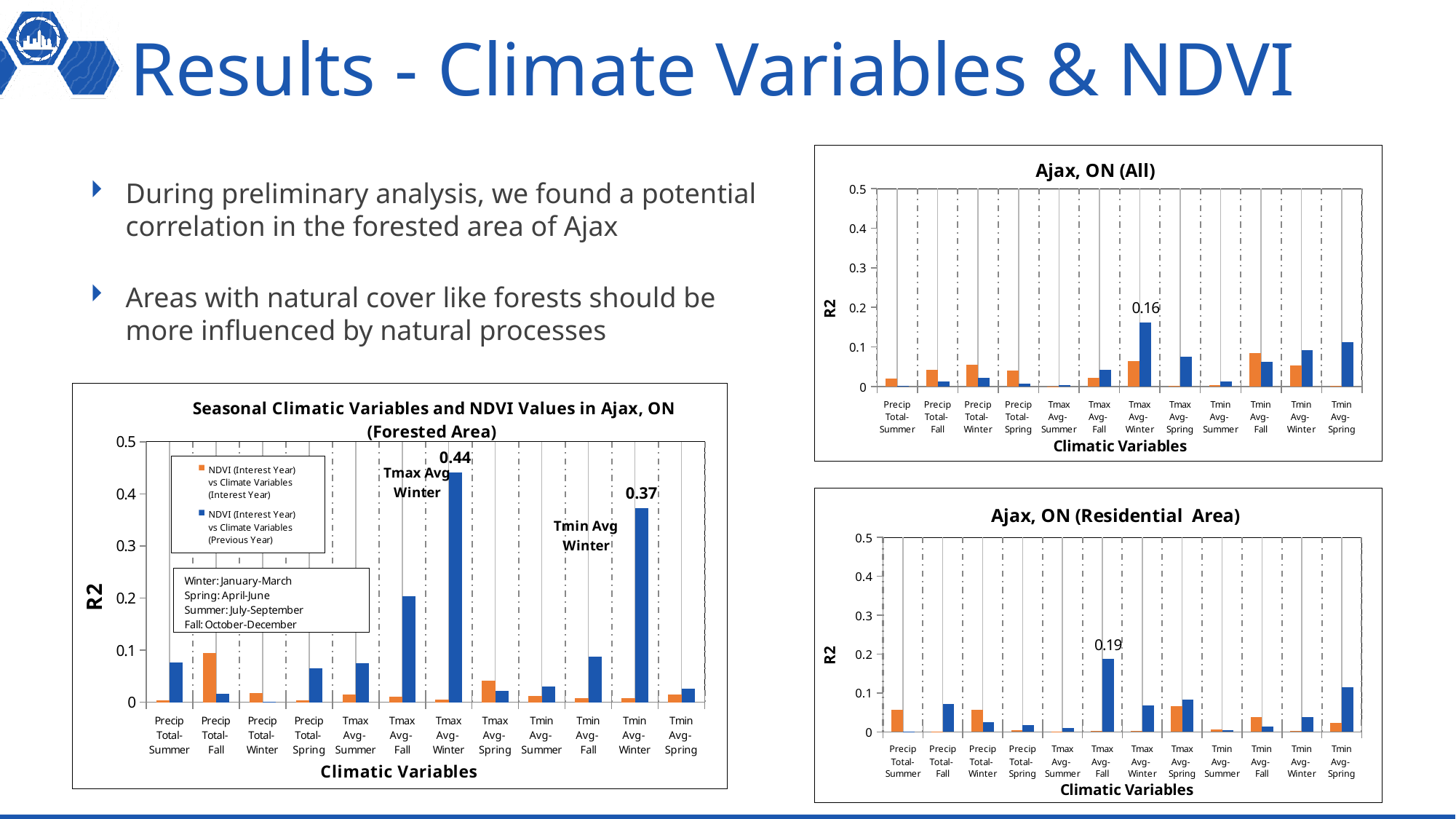
How many series does the legend of the Forested Area chart list? 2 In the 'Ajax, ON (Residential Area)' chart, which climatic variable has the highest R2 value? Tmax Avg-Fall In the 'Seasonal Climatic Variables and NDVI Values in Ajax, ON (Forested Area)' chart, what is the R2 value for Tmin Avg-Winter in the NDVI (Interest Year) vs Climate Variables (Previous Year) series? 0.37 In the Forested Area chart, is the R2 value for Tmin Avg-Winter in the Previous Year series greater or less than 0.3? greater How many climatic variable categories are shown on the x axis of the Forested Area chart? 12 In the Forested Area chart, which climatic variable has the highest R2 value? Tmax Avg-Winter What kind of chart is the 'Ajax, ON (All)' chart? Bar chart In the Forested Area chart, what is the difference between the labelled values for Tmax Avg-Winter (0.44) and Tmin Avg-Winter (0.37)? 0.07 In the 'Seasonal Climatic Variables and NDVI Values in Ajax, ON (Forested Area)' chart, what is the R2 value for Tmax Avg-Winter in the NDVI (Interest Year) vs Climate Variables (Previous Year) series? 0.44 In the 'Ajax, ON (All)' chart, what is the labelled R2 value for Tmax Avg-Winter? 0.16 In the 'Ajax, ON (All)' chart, which climatic variable has the highest R2 value? Tmax Avg-Winter In the 'Ajax, ON (Residential Area)' chart, what is the labelled R2 value for Tmax Avg-Fall? 0.19